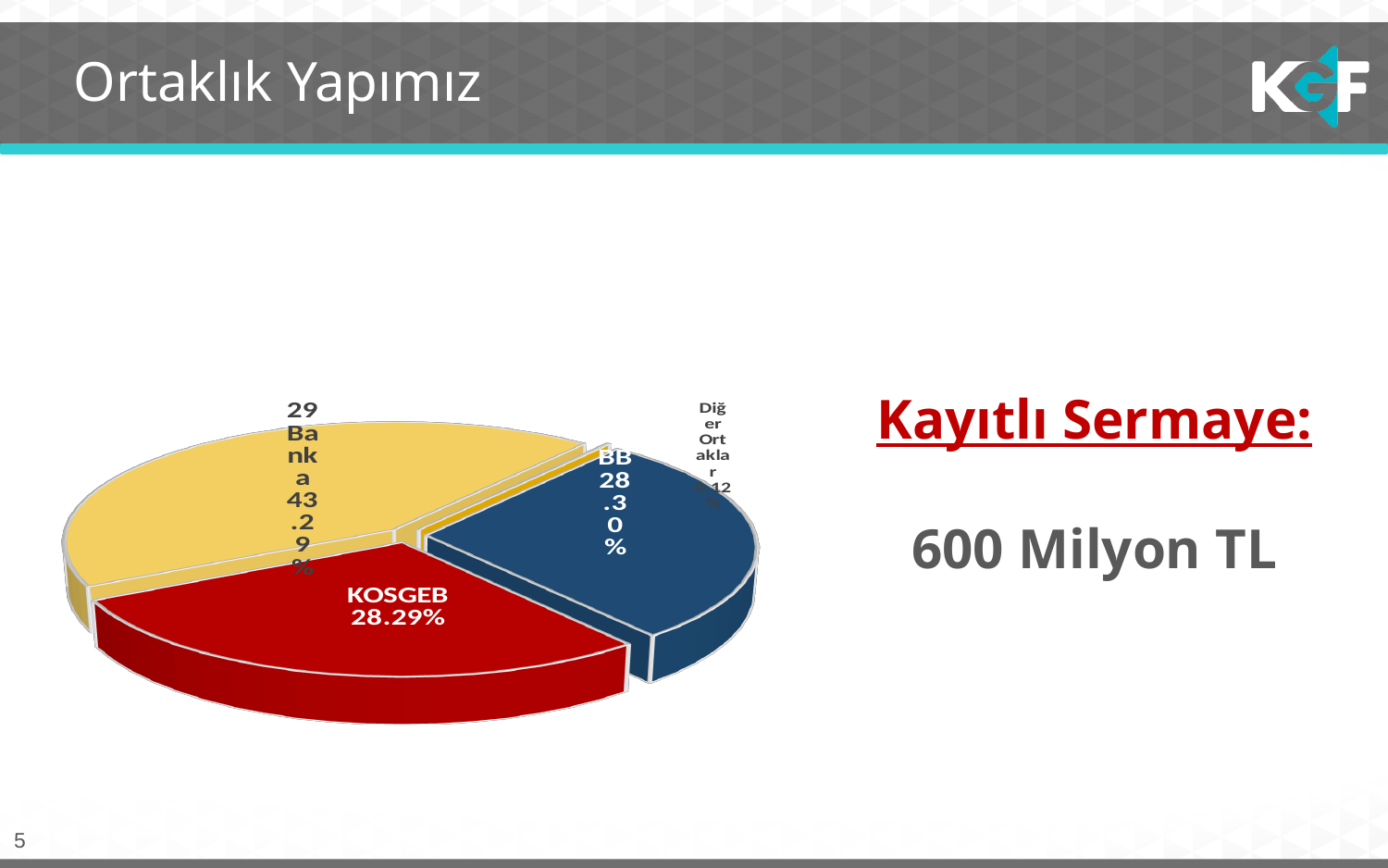
What share of the pie does KOSGEB hold? 28.29% What is the title of the slide containing the pie chart? Ortaklık Yapımız What share of the pie does 29 Banka hold? 43.29% What percentage is labelled on the blue slice of the pie? 28.30% How many slices does the pie chart have? 4 Which is larger, the share of 29 Banka or the share of KOSGEB? 29 Banka Which slice of the pie is the smallest? Diğer Ortaklar Which slice of the pie is the largest? 29 Banka By how many percentage points does the 29 Banka share exceed the KOSGEB share? 15.00 percentage points What type of chart is shown on the slide? Pie chart Is the share of 29 Banka greater or less than 40%? greater What colour is the KOSGEB slice? Red